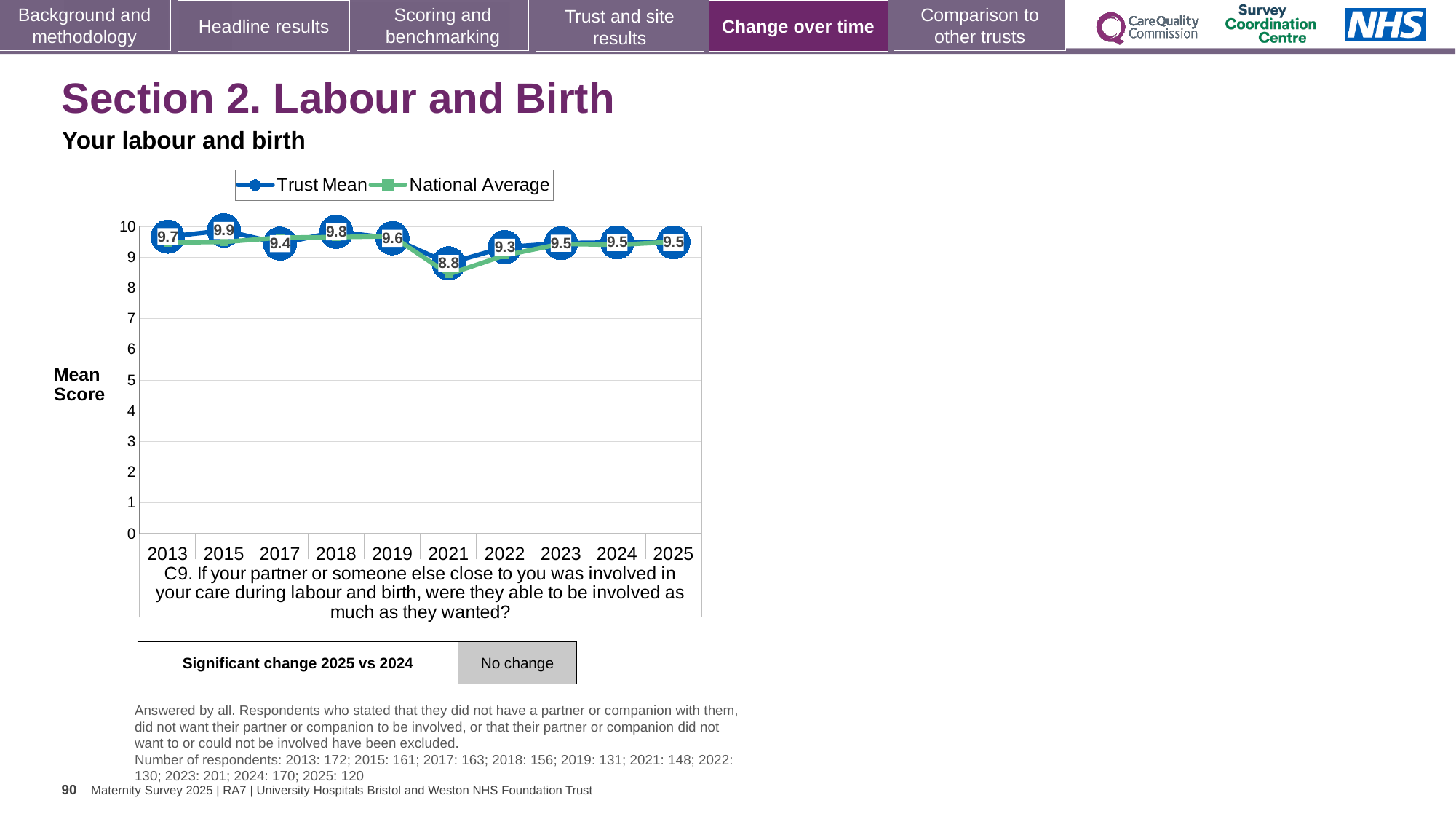
What is the Trust Mean score for 2021? 8.8 What is the Trust Mean score for 2015? 9.9 How many series does the legend list? 2 Which year has a higher Trust Mean score, 2018 or 2022? 2018 Does the Trust Mean score rise or fall from 2019 to 2021? Fall Is the National Average value for 2021 greater or less than 9? less What is the Trust Mean score for 2025? 9.5 What kind of chart is shown on the slide? Line chart What is the difference between the Trust Mean scores for 2015 and 2021? 1.1 In which year is the Trust Mean score lowest? 2021 In which year is the Trust Mean score highest? 2015 How many years are shown on the x axis of the chart? 10